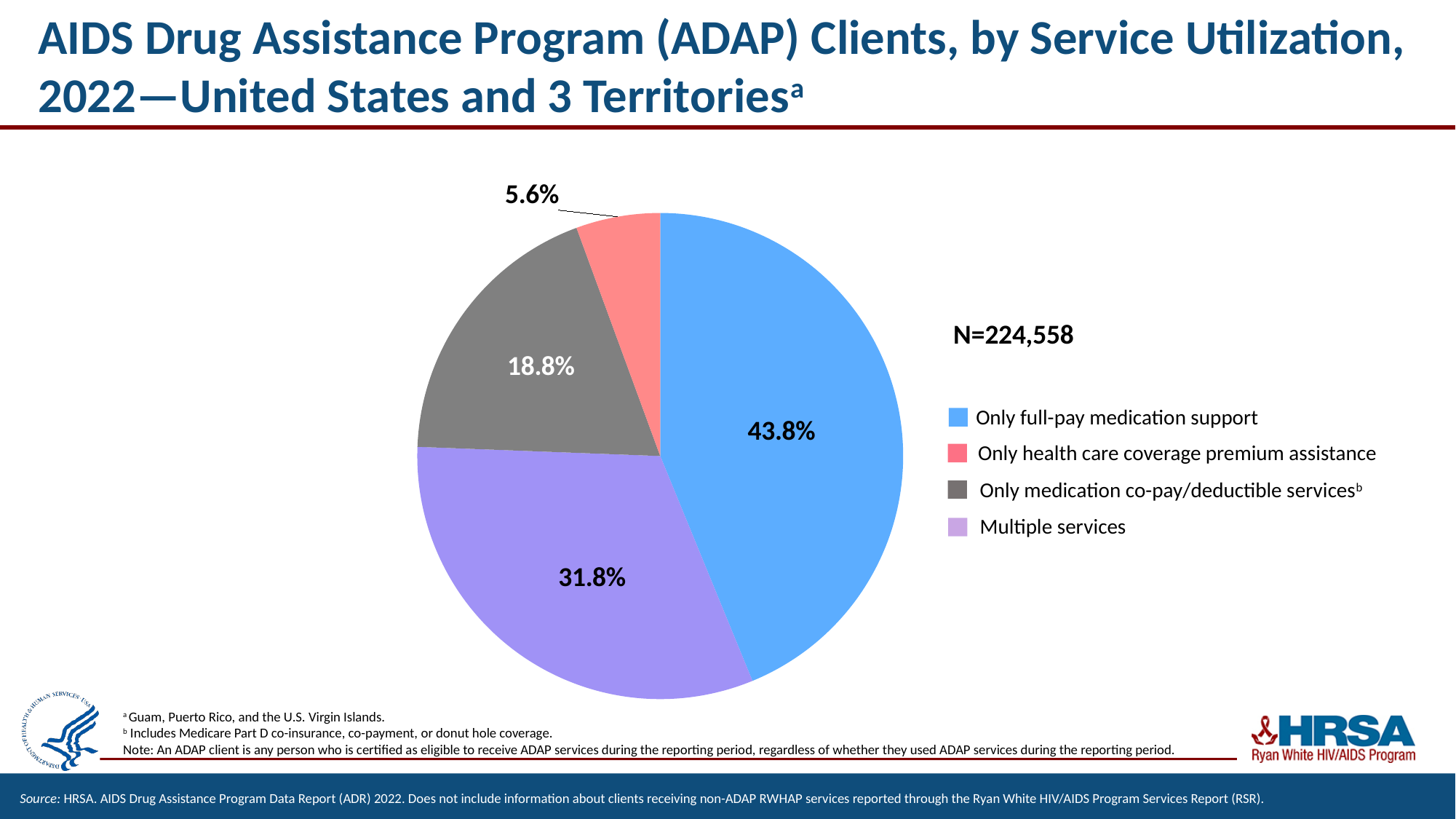
What percentage of ADAP clients received only health care coverage premium assistance? 5.6% Which colour represents the Multiple services category in the pie chart? Purple What is the difference in percentage points between the Multiple services slice and the Only medication co-pay/deductible services slice? 13.0 What is the total number of ADAP clients (N) shown on the slide? N=224,558 What percentage of ADAP clients received only medication co-pay/deductible services? 18.8% What percentage of ADAP clients received only full-pay medication support? 43.8% Which service utilization category has the largest share of ADAP clients? Only full-pay medication support What percentage of ADAP clients received multiple services? 31.8% What kind of chart is shown on the slide? Pie chart How many slices does the pie chart have? 4 Which service utilization category has the smallest share of ADAP clients? Only health care coverage premium assistance Which is larger: the share for Multiple services or the share for Only medication co-pay/deductible services? Multiple services